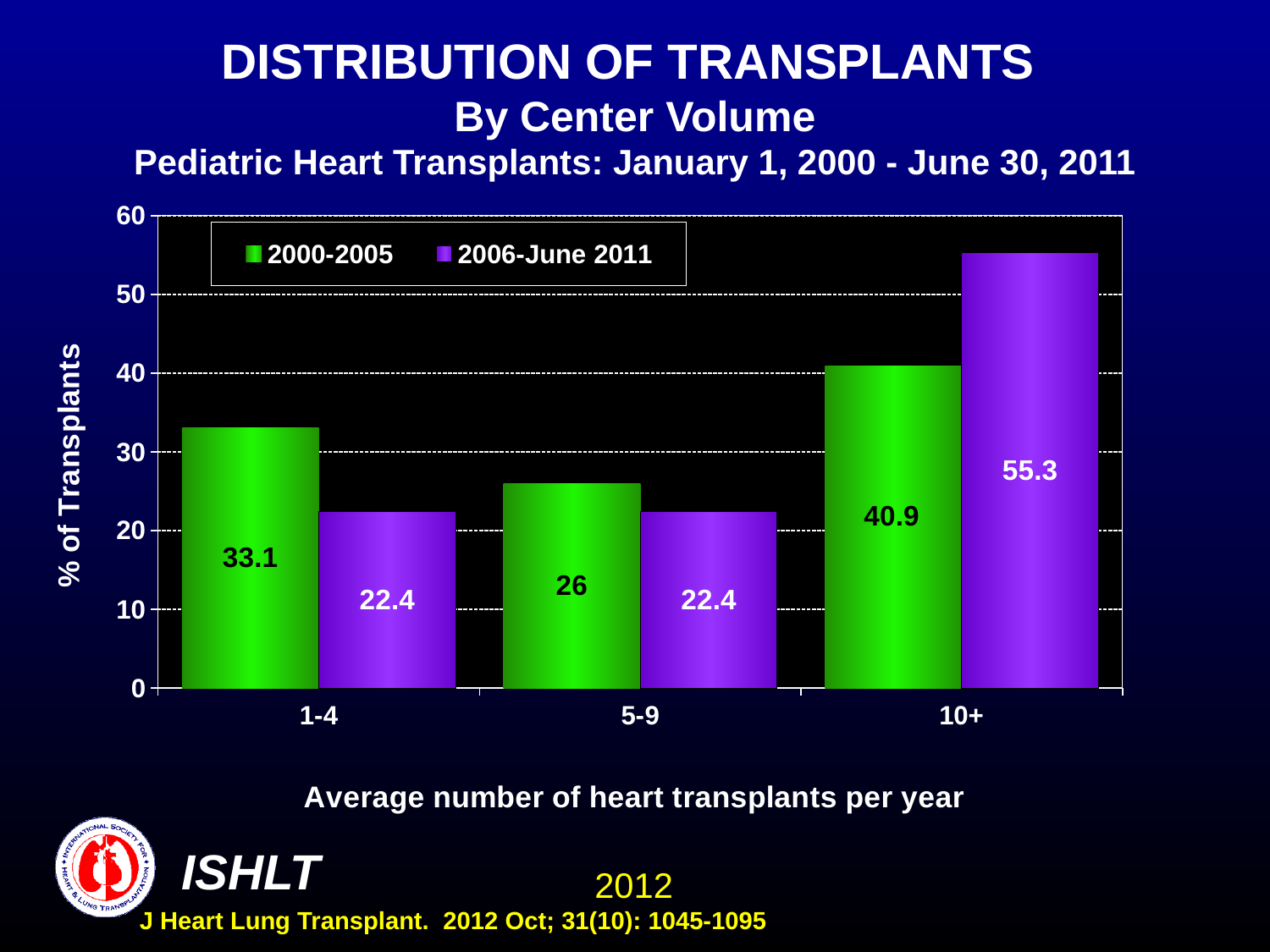
What is the difference between the 2006-June 2011 and 2000-2005 values in the 10+ category? 14.4 What kind of chart is shown on the slide? bar chart What is the value for the 2000-2005 series in the 5-9 category? 26 Which category has the lowest value for the 2000-2005 series? 5-9 What is the label of the y axis? % of Transplants Is the value for the 2000-2005 series in the 10+ category greater or less than 50? less What is the value for the 2000-2005 series in the 1-4 category? 33.1 In the 1-4 category, which series has the larger value, 2000-2005 or 2006-June 2011? 2000-2005 What is the value for the 2006-June 2011 series in the 10+ category? 55.3 How many series does the legend list? 2 How many categories are shown on the x axis? 3 Which category has the highest value for the 2006-June 2011 series? 10+